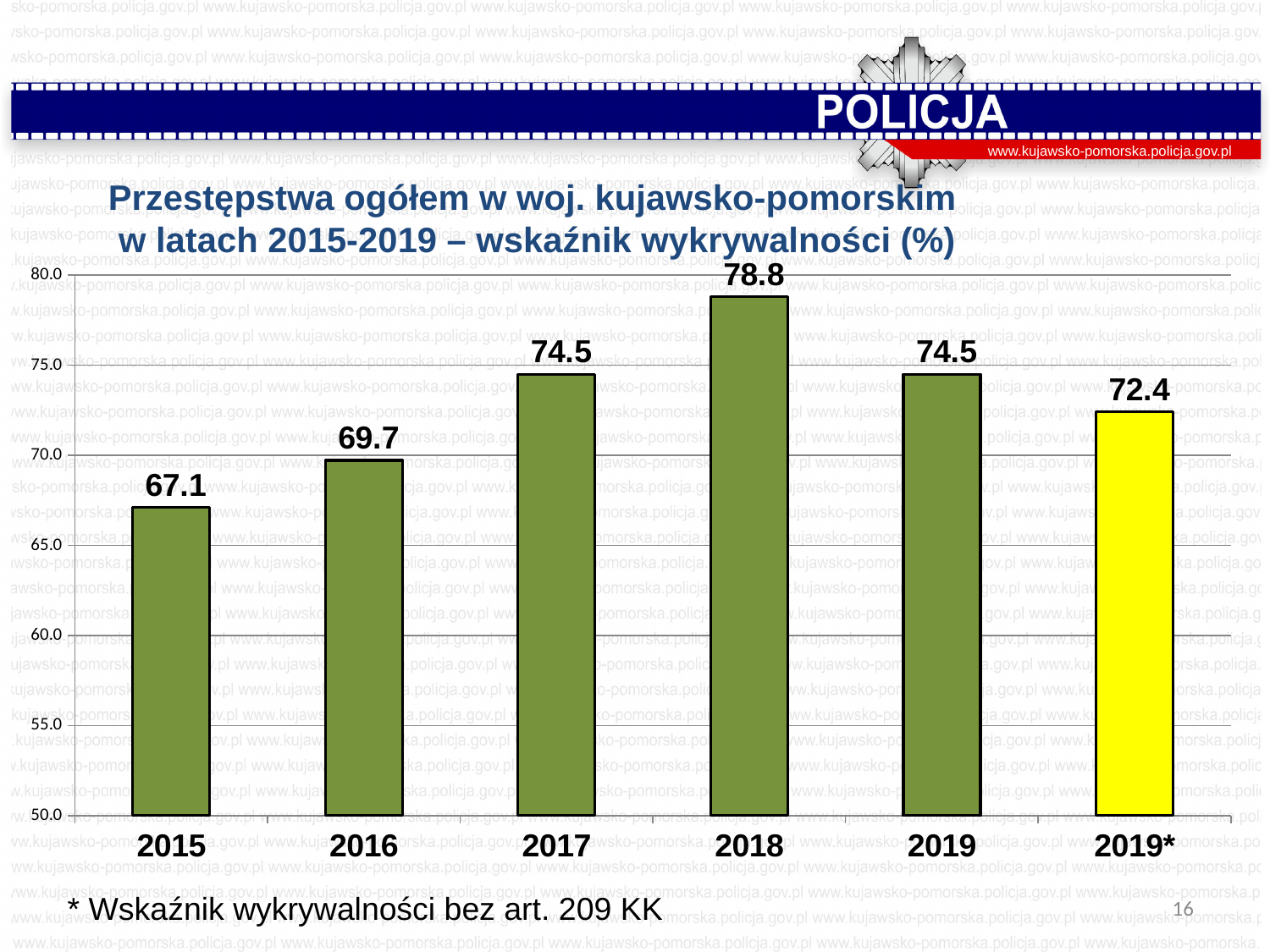
Which is larger, the value for 2016 or the value for 2017? 2017 What is the detection rate value shown for 2015? 67.1 What kind of chart is shown on the slide? bar chart What is the difference between the values for 2018 and 2015? 11.7 Is the value for 2016 greater or less than 70.0? less Which category has the lowest value in the chart? 2015 What value is shown for the 2019* bar? 72.4 How many bars are shown in the chart? 6 Which bar is coloured yellow instead of green? 2019* Which year has the highest value in the chart? 2018 What value is shown for 2018? 78.8 What is the difference between the values for 2019 and 2019*? 2.1